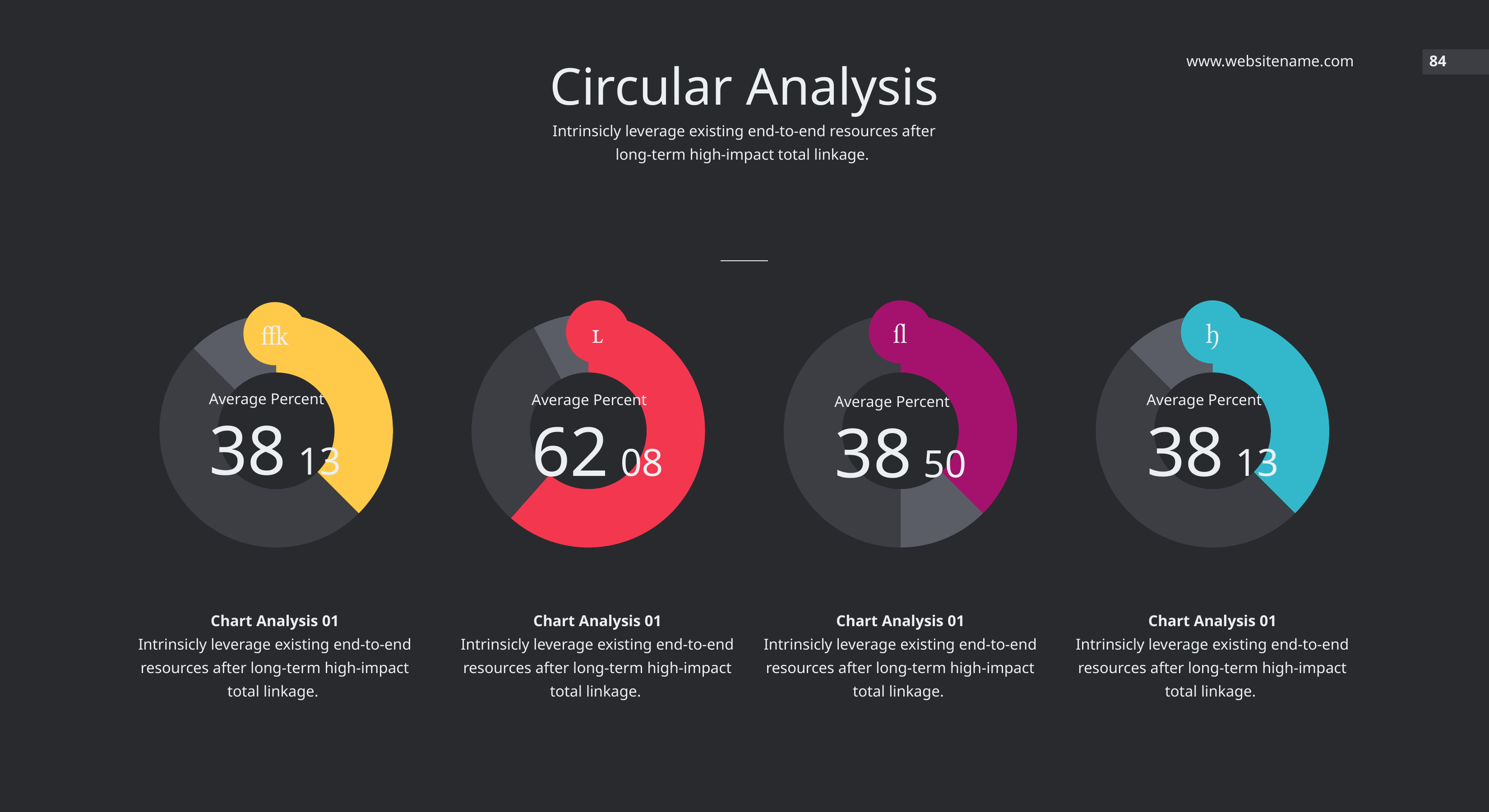
What colour is the highlighted segment of the third chart? Magenta What large number is printed in the centre of the first (yellow) chart? 38 What smaller number follows the 38 in the centre of the fourth (blue) chart? 13 What smaller number follows the 38 in the centre of the third (magenta) chart? 50 What is the title of the slide containing the four charts? Circular Analysis Which has the larger centre number, the first (yellow) chart or the second (red) chart? The second (red) chart Which chart shows the highest large centre number? The second (red) chart, 62 How many circular charts are shown on the slide? 4 What large number is printed in the centre of the second (red) chart? 62 What kind of chart is used for each of the four figures on the slide? Donut (pie) chart What smaller number follows the 62 in the centre of the second chart? 08 What label appears above the number in the centre of each chart? Average Percent